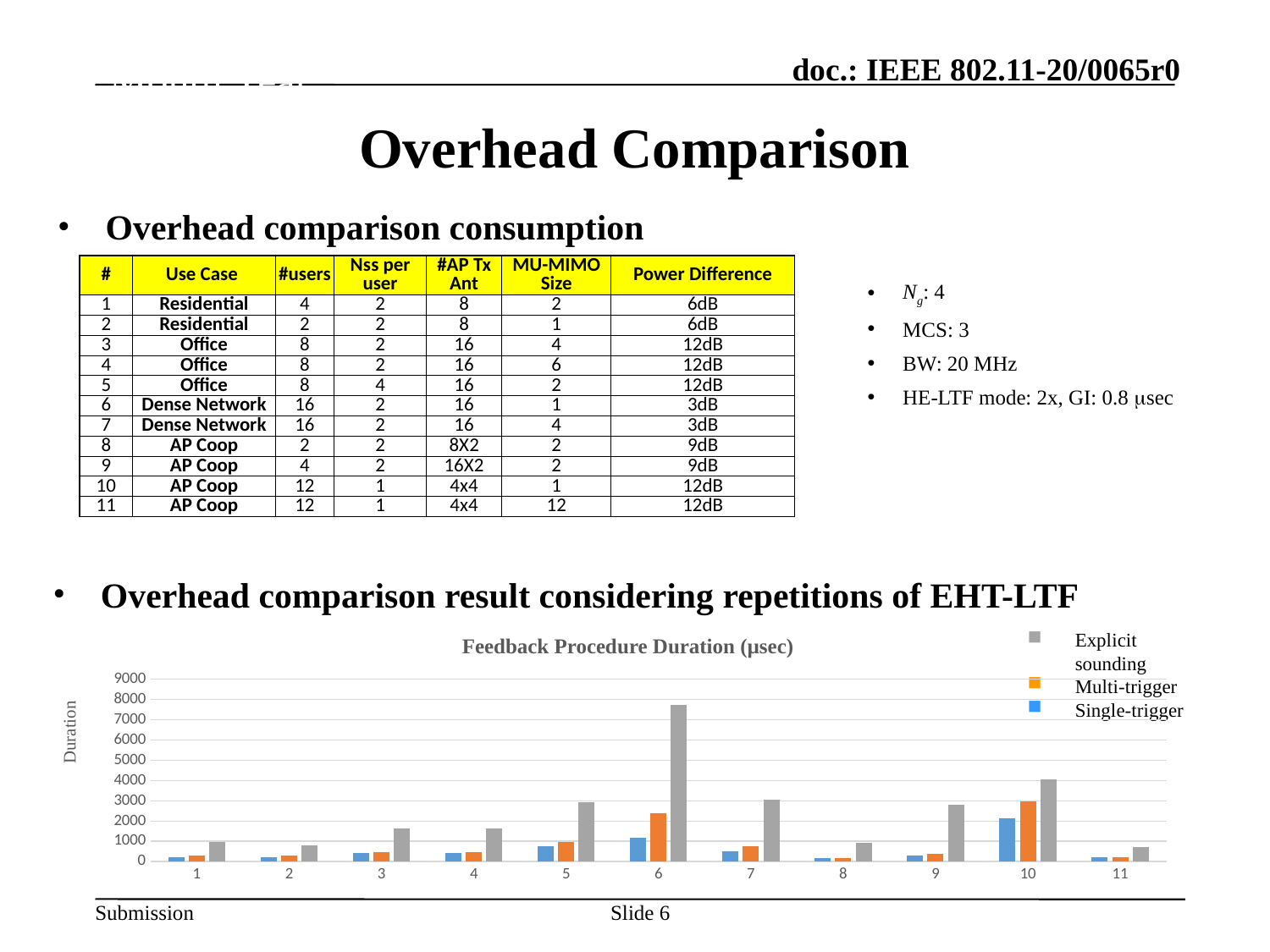
Which category has the highest Single-trigger value? 10 What is the title of the chart? Feedback Procedure Duration (μsec) Which category has the highest Explicit sounding value? 6 How many categories are shown along the x axis of the chart? 11 Is the Multi-trigger value for category 6 greater or less than 2000? greater What kind of chart is shown on the slide? bar chart For category 10, which is larger: the Single-trigger value or the Multi-trigger value? Multi-trigger Which series is drawn in gray in the chart? Explicit sounding Is the Explicit sounding value for category 1 greater or less than 2000? less How many series does the chart's legend list? 3 Which category has the highest Multi-trigger value? 10 Is the Explicit sounding value for category 6 greater or less than 7000? greater